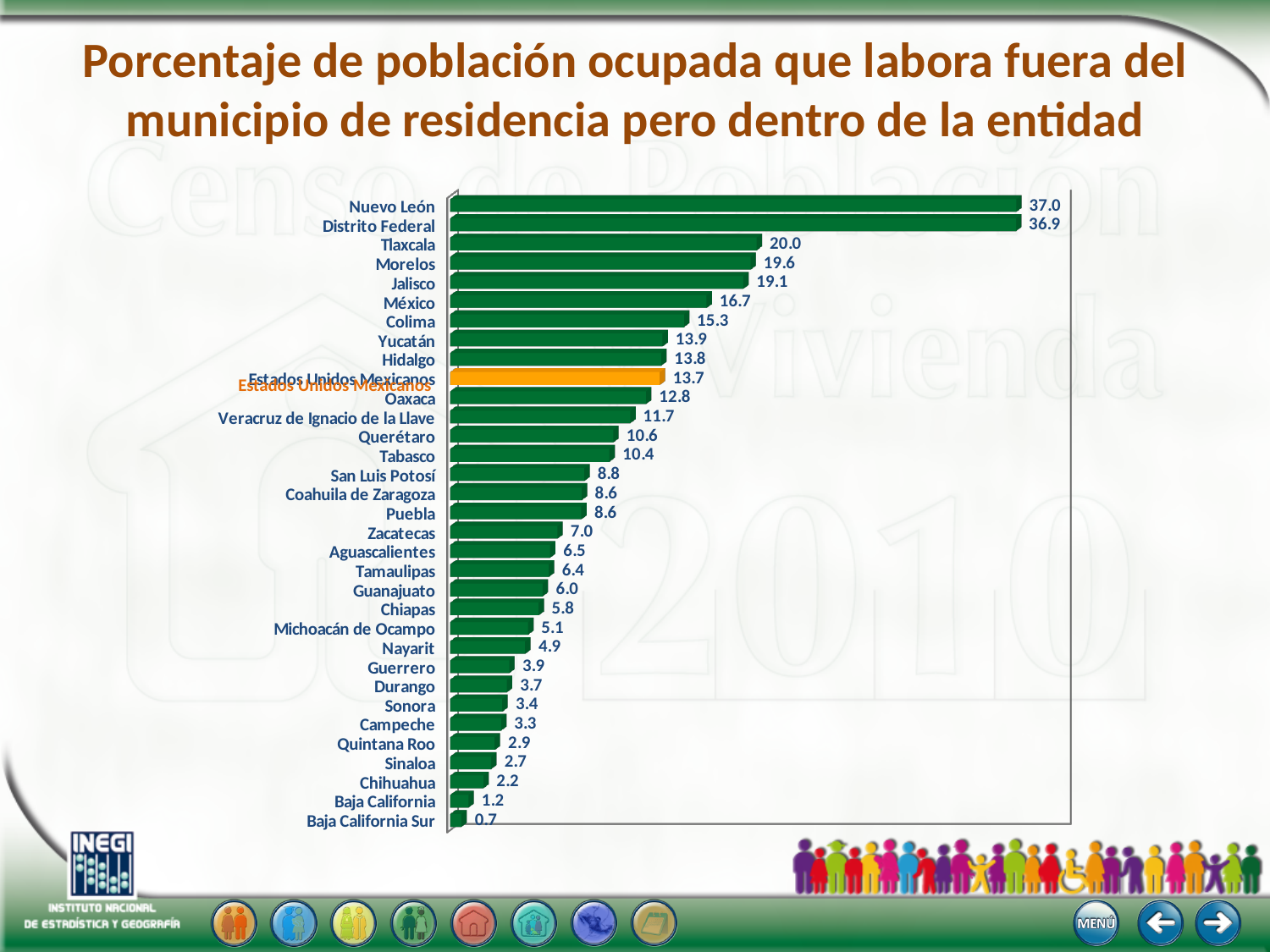
What is the value for Chihuahua? 2.2 How many categories are shown in the chart? 33 What is the value for Querétaro? 10.6 Which category has the lowest value? Baja California Sur Which bar is highlighted in a different colour (orange) from the rest? Estados Unidos Mexicanos Which category has the highest value? Nuevo León What is the difference between the values for Tlaxcala and Morelos? 0.4 What is the difference between the values for Nuevo León and Distrito Federal? 0.1 Which has a larger value, Jalisco or México? Jalisco What kind of chart is shown on the slide? Bar chart What is the value for Estados Unidos Mexicanos? 13.7 What is the value for Nuevo León? 37.0